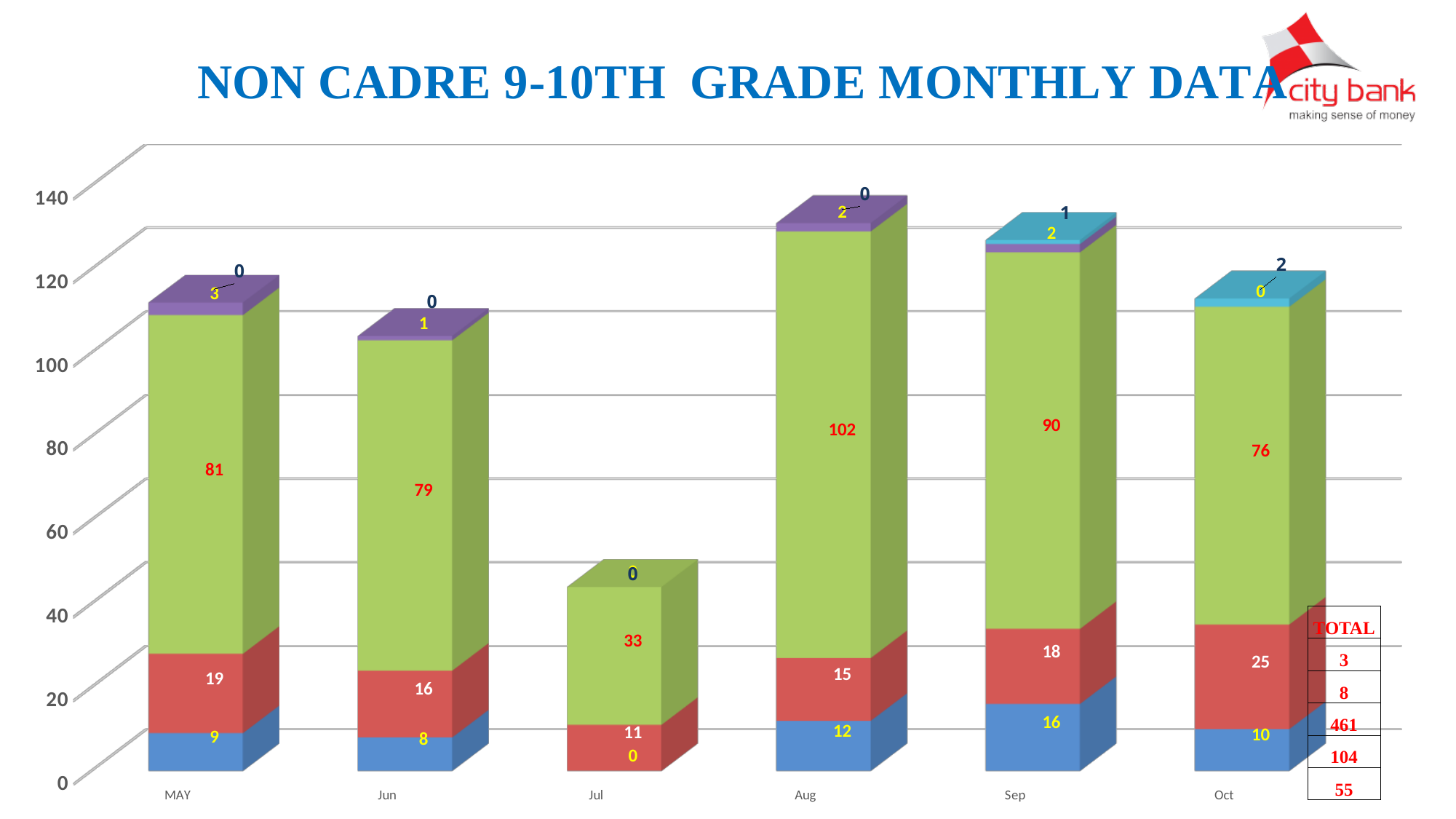
Which is larger, the red segment for Oct or the red segment for Sep? Oct What is the difference between the green segment values for Aug and Sep? 12 What is the total of the stacked bar for Jul? 44 What is the value of the red segment for Oct? 25 Which month has the smallest green segment? Jul What is the value of the blue bottom segment for Sep? 16 What is the value of the green segment for Aug? 102 What kind of chart is shown on the slide? Stacked bar chart What is the total of the stacked bar for MAY? 112 Is the total height of the Aug bar greater or less than 120? greater Which month has the largest green segment? Aug How many months are shown on the x axis? 6